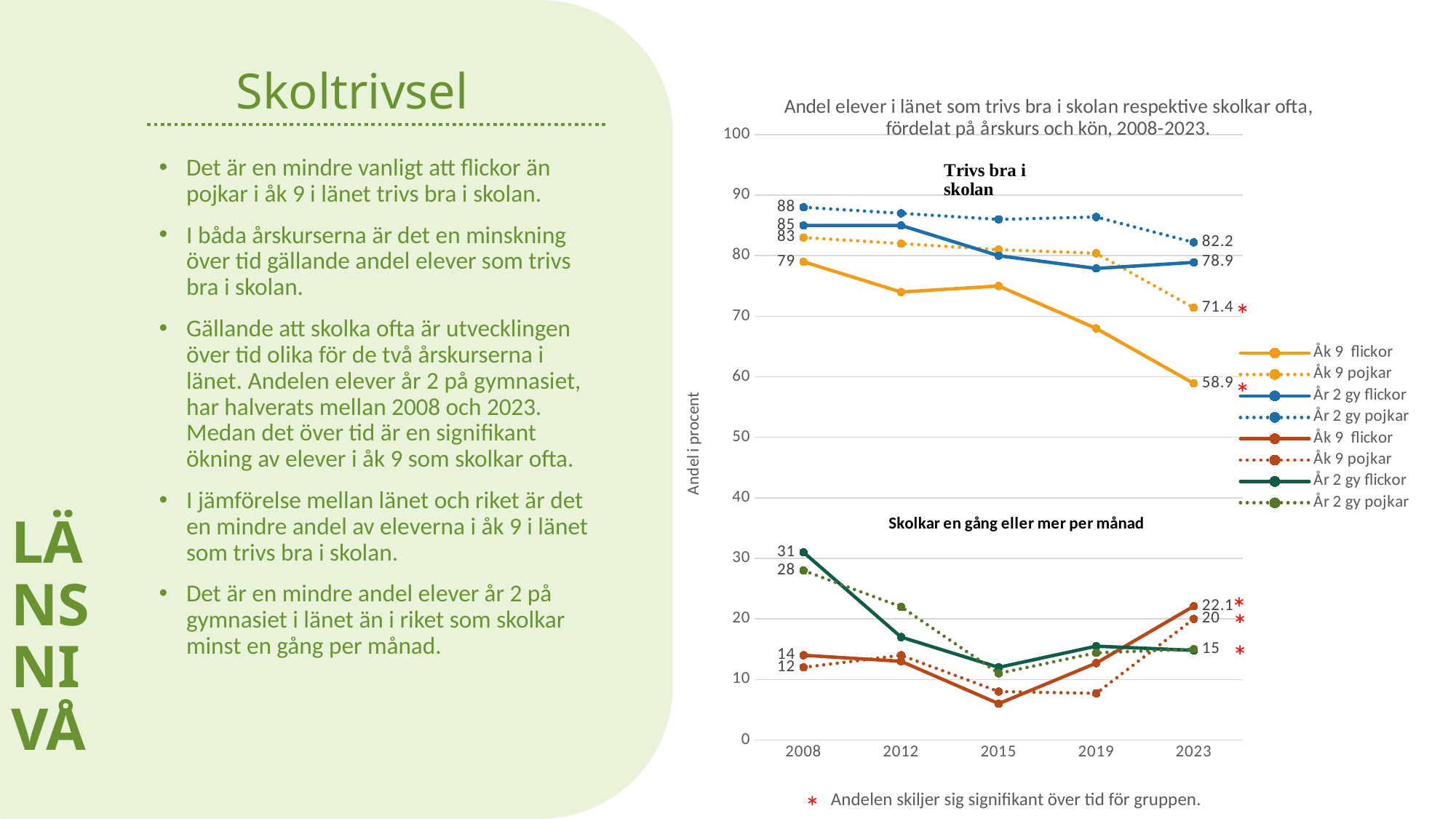
Is the value for Åk 9 flickor who skolkar en gång eller mer per månad in 2015 greater or less than 10? less What kind of chart is shown on the slide? line chart What is the value for Åk 9 pojkar who trivs bra i skolan in 2023? 71.4 What is the value for Åk 9 flickor who trivs bra i skolan in 2023? 58.9 What is the value for År 2 gy pojkar who trivs bra i skolan in 2008? 88 Which group had the higher share who trivs bra i skolan in 2023, År 2 gy pojkar or År 2 gy flickor? År 2 gy pojkar What is the value for År 2 gy flickor who skolkar en gång eller mer per månad in 2008? 31 How many series does the legend list? 8 By how much did the share of Åk 9 flickor who trivs bra i skolan fall from 2008 to 2023? 20.1 Does the share of Åk 9 flickor who trivs bra i skolan rise or fall from 2008 to 2023? fall How many years are shown on the x axis? 5 What is the value for Åk 9 flickor who skolkar en gång eller mer per månad in 2023? 22.1